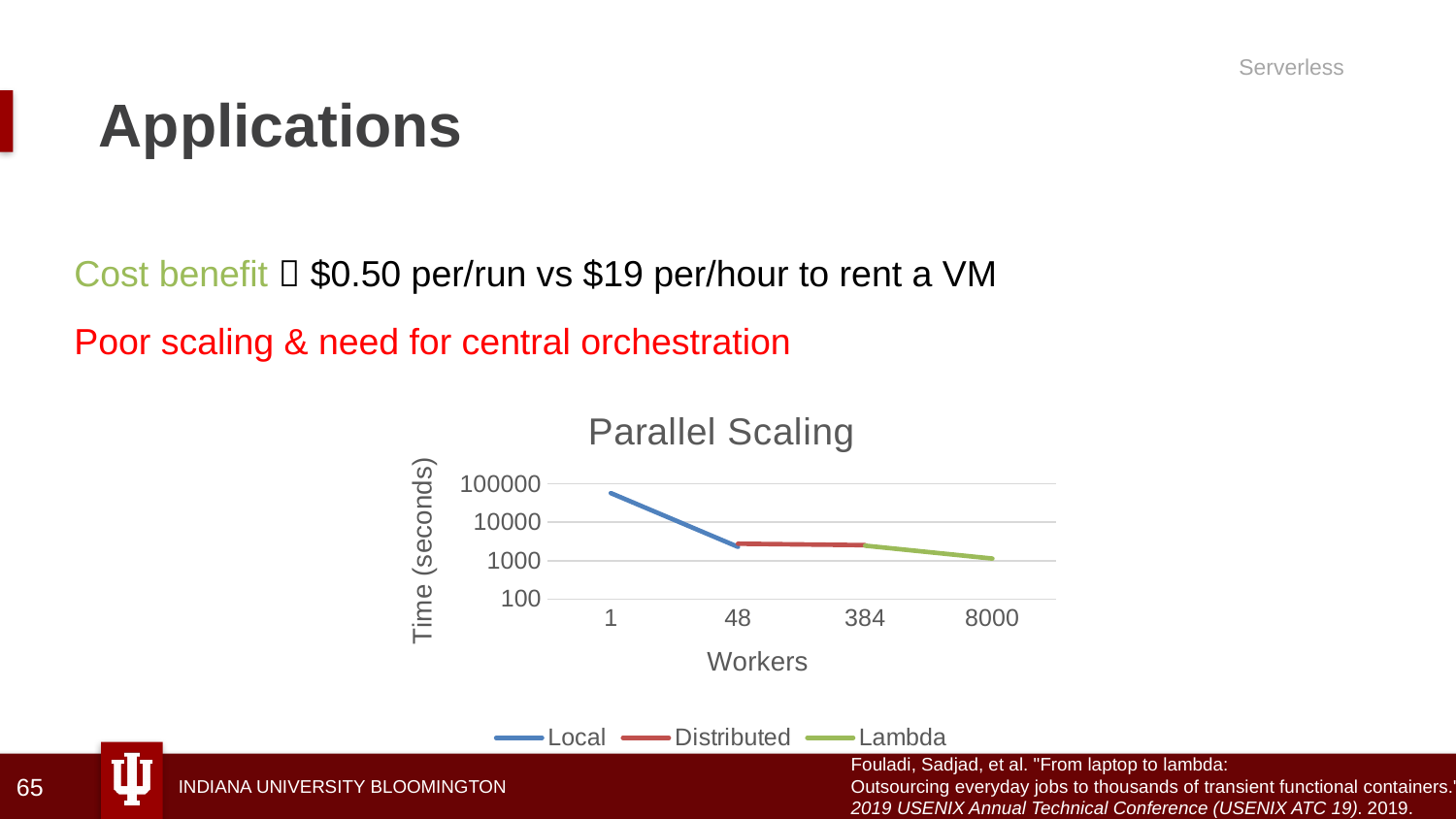
In the "Parallel Scaling" chart, which number of workers has the lowest time? 8000 What kind of chart is the "Parallel Scaling" chart? line chart What is the title of the chart on the slide? Parallel Scaling In the "Parallel Scaling" chart, which number of workers has the highest time? 1 In the "Parallel Scaling" chart, which has the larger time: 1 worker or 48 workers? 1 worker In the "Parallel Scaling" chart, is the time for 1 worker greater or less than 10000 seconds? greater What is the label of the y axis in the "Parallel Scaling" chart? Time (seconds) In the "Parallel Scaling" chart, is the time for 48 workers greater or less than 1000 seconds? greater In the "Parallel Scaling" chart, does the time rise or fall as the number of workers increases? fall How many worker counts are shown on the x axis of the "Parallel Scaling" chart? 4 How many series does the legend of the "Parallel Scaling" chart list? 3 In the "Parallel Scaling" chart, is the time for 8000 workers greater or less than 10000 seconds? less